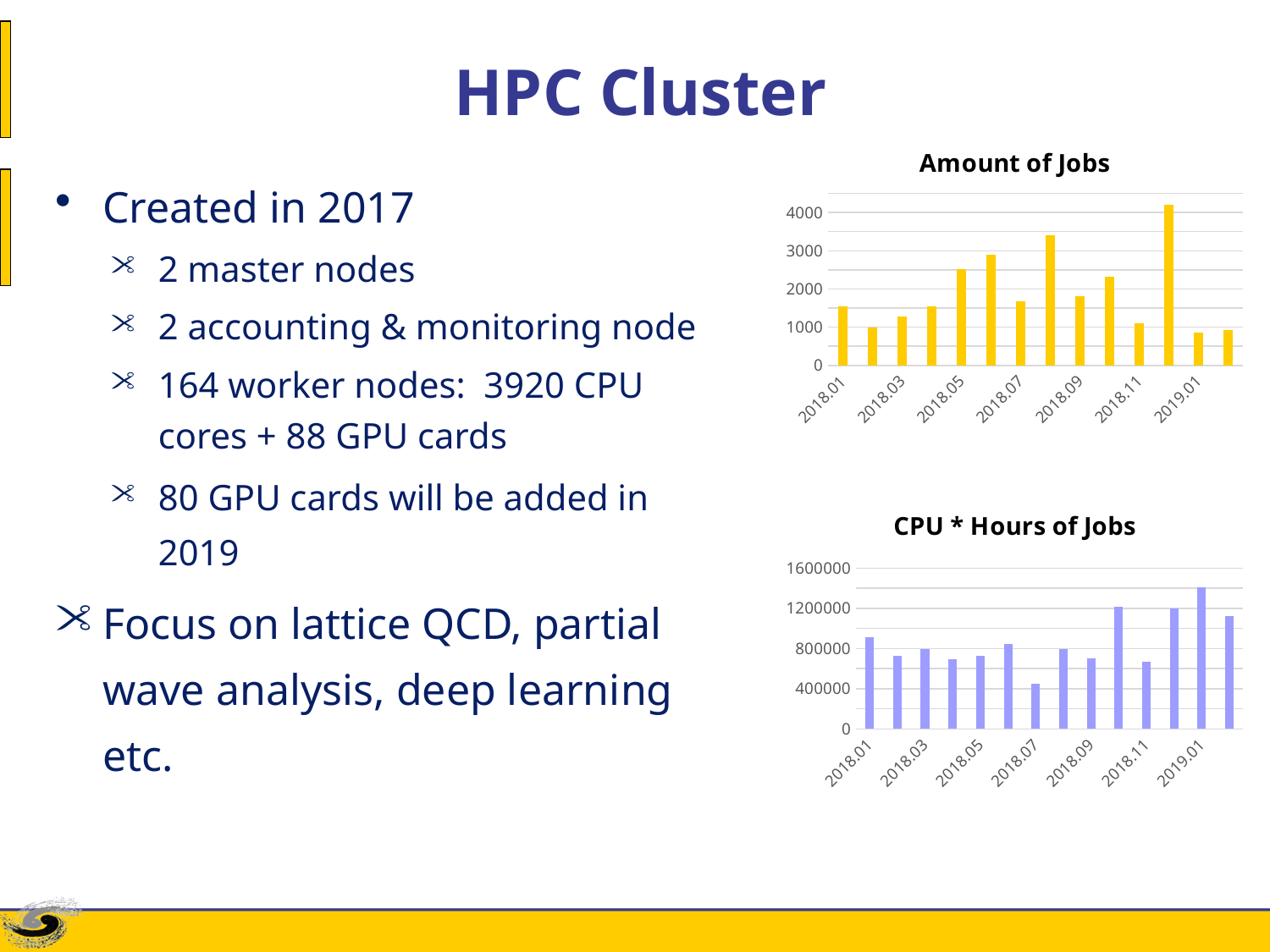
In the "CPU * Hours of Jobs" chart, which labelled month has the lowest value? 2018.07 In the "Amount of Jobs" chart, how many bars are plotted? 14 In the "Amount of Jobs" chart, is the value for 2019.01 greater or less than 1000? less In the "CPU * Hours of Jobs" chart, is the value for 2019.01 greater or less than 1200000? greater In the "CPU * Hours of Jobs" chart, how many bars are plotted? 14 In the "CPU * Hours of Jobs" chart, is the value for 2018.07 greater or less than 800000? less In the "CPU * Hours of Jobs" chart, which labelled month has the highest value? 2019.01 In the "Amount of Jobs" chart, which is larger, the value for 2018.03 or the value for 2018.05? 2018.05 What is the title of the chart at the top right of the slide? Amount of Jobs What kind of chart is the "Amount of Jobs" chart? bar chart What kind of chart is the "CPU * Hours of Jobs" chart? bar chart